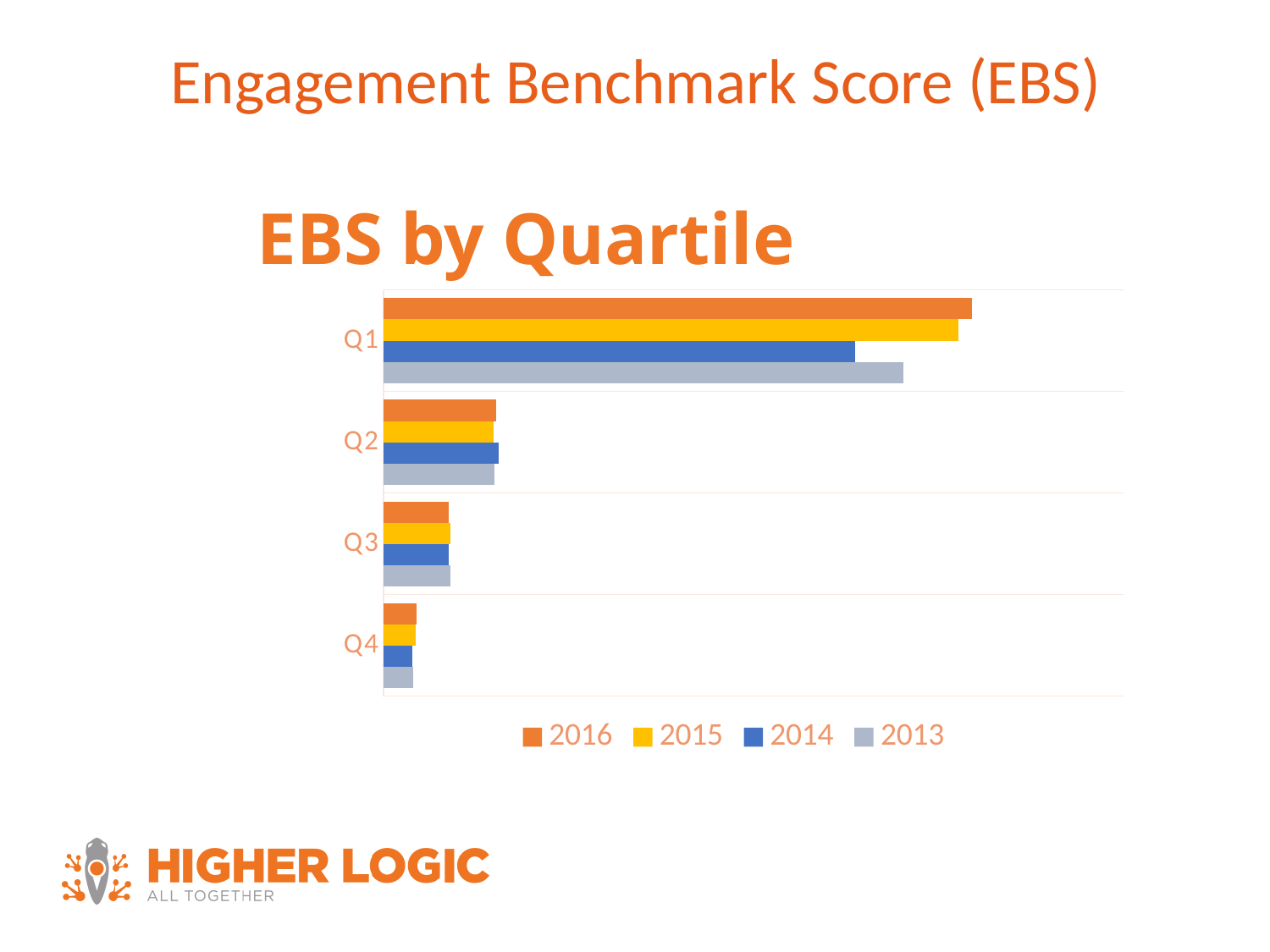
Within Q1, which year has the longest bar? 2016 How many quartile categories are plotted on the chart? 4 Which quartile has the highest EBS values across all years? Q1 What kind of chart is shown on the slide? bar chart Which quartile has the lowest EBS values across all years? Q4 What is the title of the chart? EBS by Quartile Which years are listed in the chart legend? 2016, 2015, 2014, 2013 Within Q1, which year has the shortest bar? 2014 Do the EBS values rise or fall going from Q1 to Q4? fall How many series does the legend list? 4 In Q1, is the value for 2015 larger or smaller than the value for 2014? larger In Q1, which is larger: the 2013 value or the 2014 value? 2013